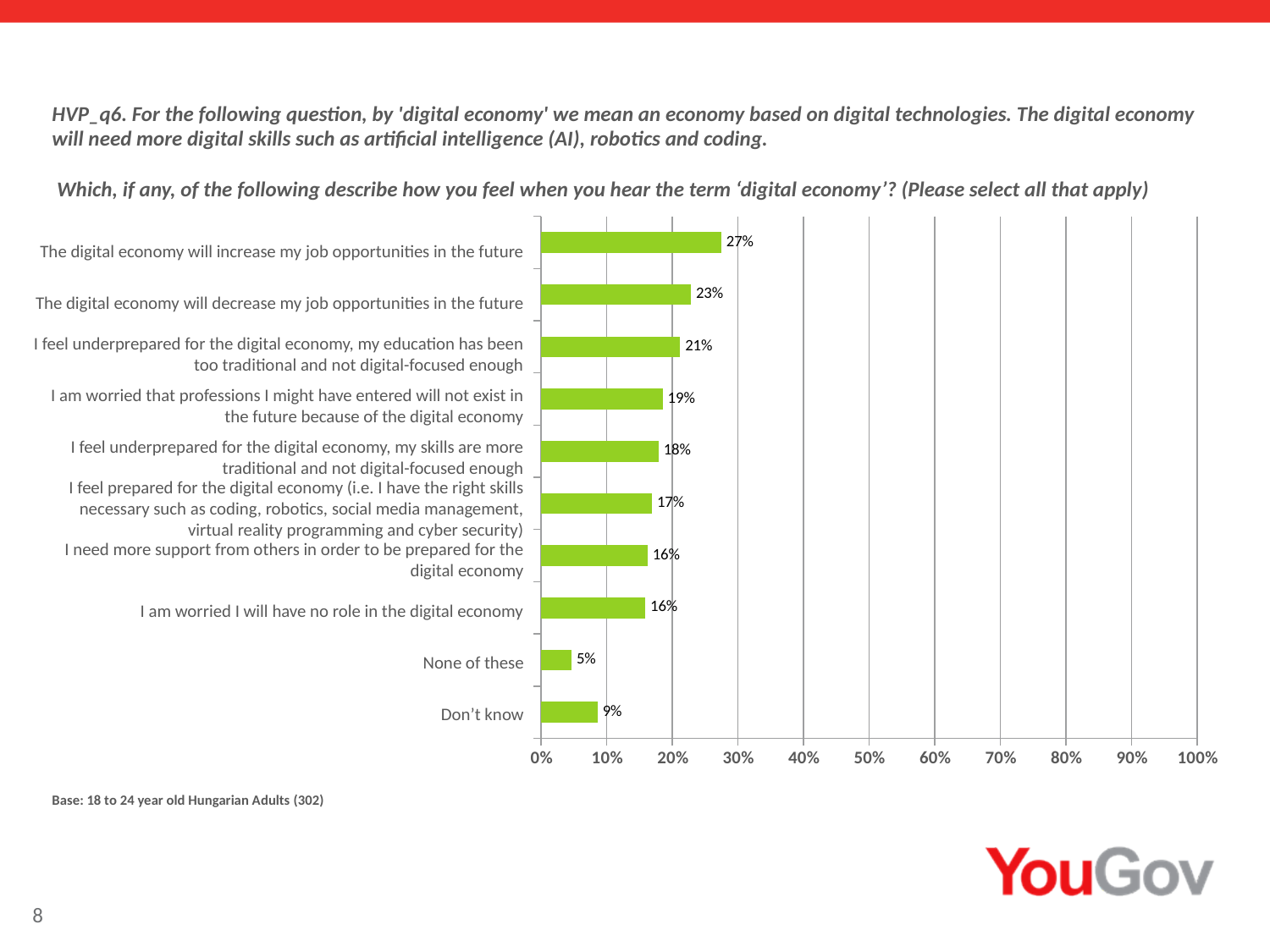
What percentage of respondents answered "Don't know"? 9% Which is larger: the value for "Don't know" or the value for "None of these"? Don't know Which category has the highest value? The digital economy will increase my job opportunities in the future What percentage of respondents said the digital economy will increase their job opportunities in the future? 27% What is the difference between the value for "The digital economy will increase my job opportunities in the future" and "The digital economy will decrease my job opportunities in the future"? 4% What is the base described below the chart? 18 to 24 year old Hungarian Adults (302) What kind of chart is shown on the slide? Bar chart How many categories are shown in the chart? 10 What is the value for "None of these"? 5% What is the value for "I am worried I will have no role in the digital economy"? 16% Which category has the lowest value? None of these Is the value for "I feel underprepared for the digital economy, my education has been too traditional and not digital-focused enough" greater or less than 30%? less